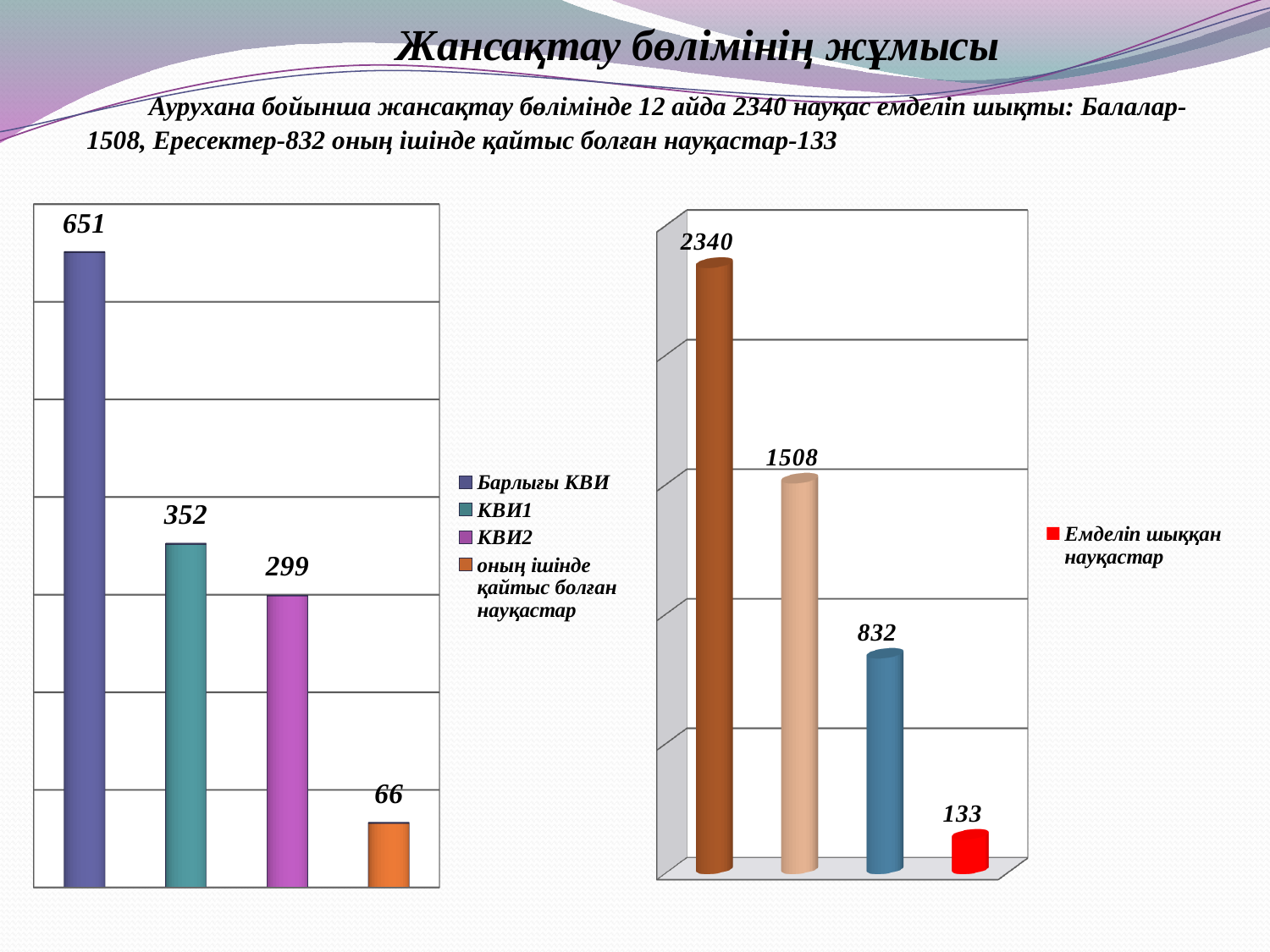
In the right chart, what is the difference between the second bar (1508) and the third bar (832)? 676 In the left chart, how many entries does the legend list? 4 In the right chart, what is the value of the tallest bar? 2340 In the left chart, what is the value for КВИ2? 299 In the left chart, what is the value for КВИ1? 352 In the left chart, what is the value for оның ішінде қайтыс болған науқастар? 66 What type of chart is the right chart? Bar chart In the left chart, what is the value for Барлығы КВИ? 651 In the left chart, what is the difference between the values for КВИ1 and КВИ2? 53 In the right chart, how many bars are plotted? 4 In the right chart, what is the value of the red bar? 133 In the left chart, which legend entry has the lowest value? оның ішінде қайтыс болған науқастар